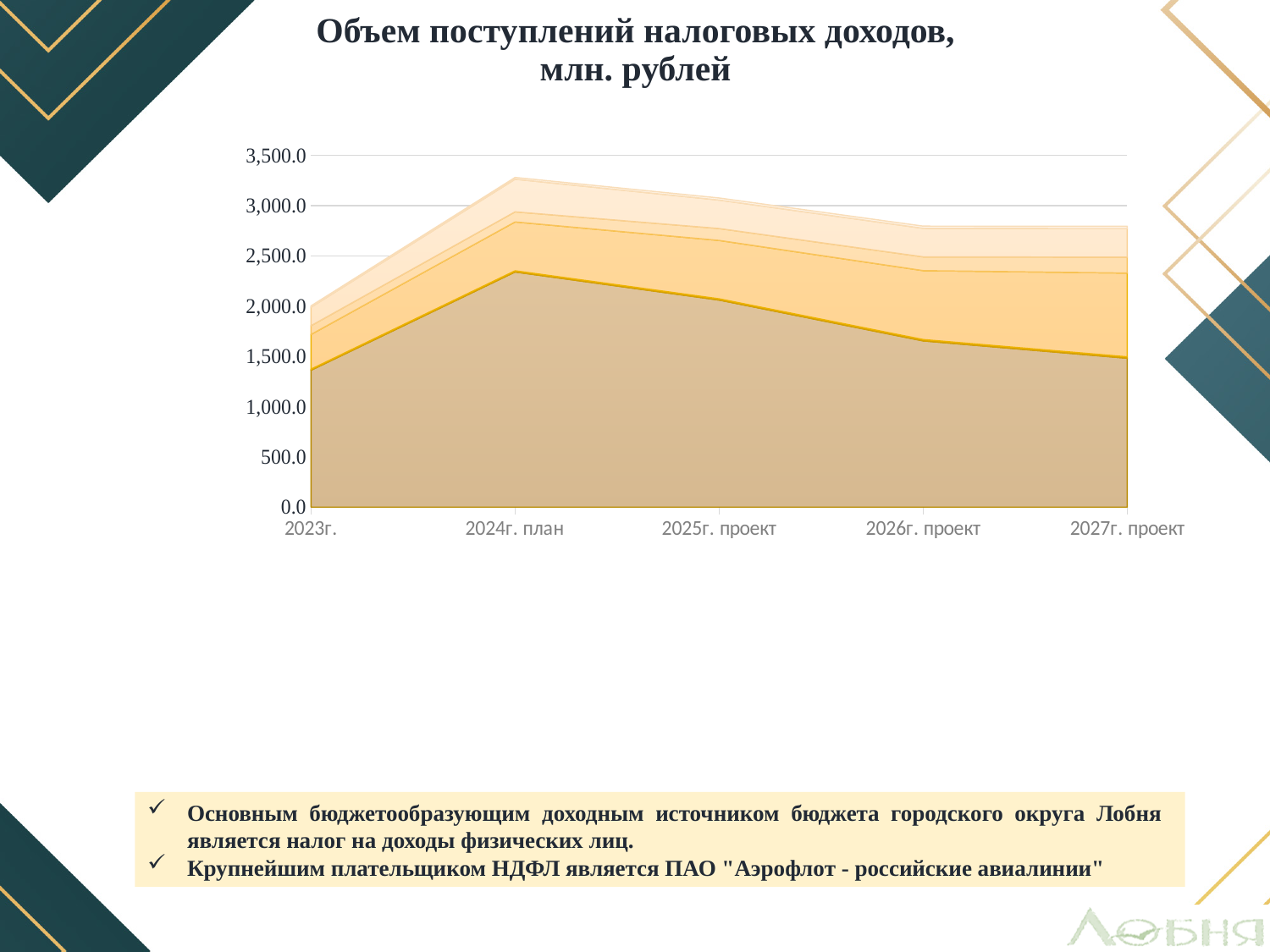
Which is larger for the bottom (darkest) area: the value for 2024г. план or for 2027г. проект? 2024г. план Is the total (top of the stacked area) for 2023г. greater or less than 2,500.0? less Which category has the highest total (top of the stacked area)? 2024г. план Is the value of the bottom (darkest) area for 2023г. greater or less than 1,500.0? less Does the total (top of the stacked area) rise or fall from 2024г. план to 2026г. проект? fall How many categories are shown along the x axis of the chart? 5 What is the title of the chart? Объем поступлений налоговых доходов, млн. рублей Is the total (top of the stacked area) for 2026г. проект greater or less than 3,000.0? less Which category has the lowest total (top of the stacked area)? 2023г. What kind of chart is shown on the slide? Area chart